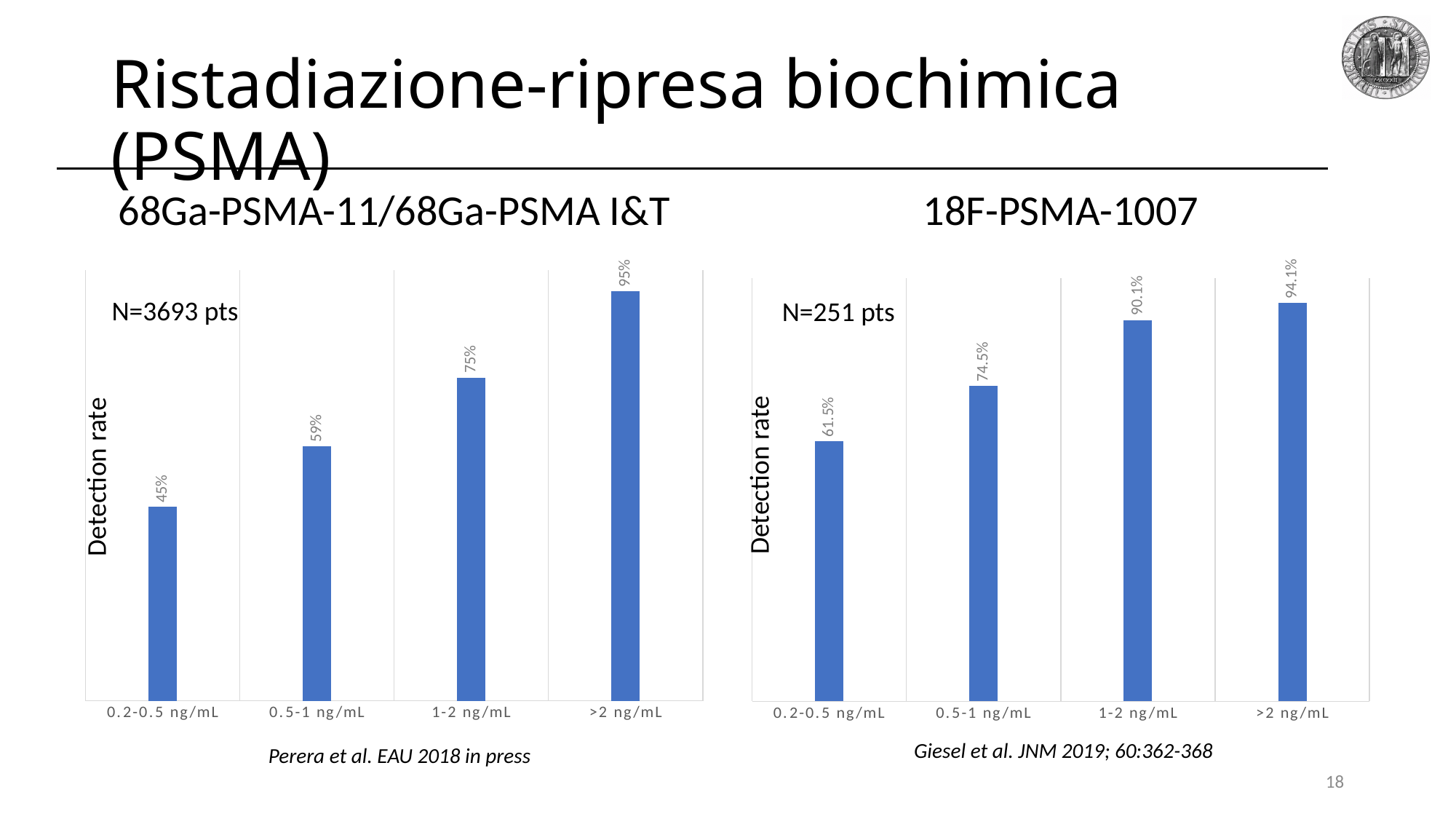
In the 18F-PSMA-1007 chart, what is the detection rate for 0.5-1 ng/mL? 74.5% How many PSA categories are shown in the 18F-PSMA-1007 chart? 4 In the 18F-PSMA-1007 chart, what is the difference between the detection rates for >2 ng/mL and 0.2-0.5 ng/mL? 32.6% In the 68Ga-PSMA-11/68Ga-PSMA I&T chart, what is the difference between the detection rates for >2 ng/mL and 1-2 ng/mL? 20% What kind of chart is the 68Ga-PSMA-11/68Ga-PSMA I&T chart? Bar chart In the 18F-PSMA-1007 chart, what is the detection rate for 1-2 ng/mL? 90.1% In the 68Ga-PSMA-11/68Ga-PSMA I&T chart, what is the detection rate for 0.2-0.5 ng/mL? 45% In the 68Ga-PSMA-11/68Ga-PSMA I&T chart, which PSA category has the highest detection rate? >2 ng/mL Which is larger: the detection rate for 0.5-1 ng/mL in the 68Ga-PSMA-11/68Ga-PSMA I&T chart or in the 18F-PSMA-1007 chart? 18F-PSMA-1007 In the 18F-PSMA-1007 chart, which PSA category has the lowest detection rate? 0.2-0.5 ng/mL In the 18F-PSMA-1007 chart, do the detection rates rise or fall as the PSA category increases along the x axis? Rise How many patients are reported for the 68Ga-PSMA-11/68Ga-PSMA I&T chart? N=3693 pts